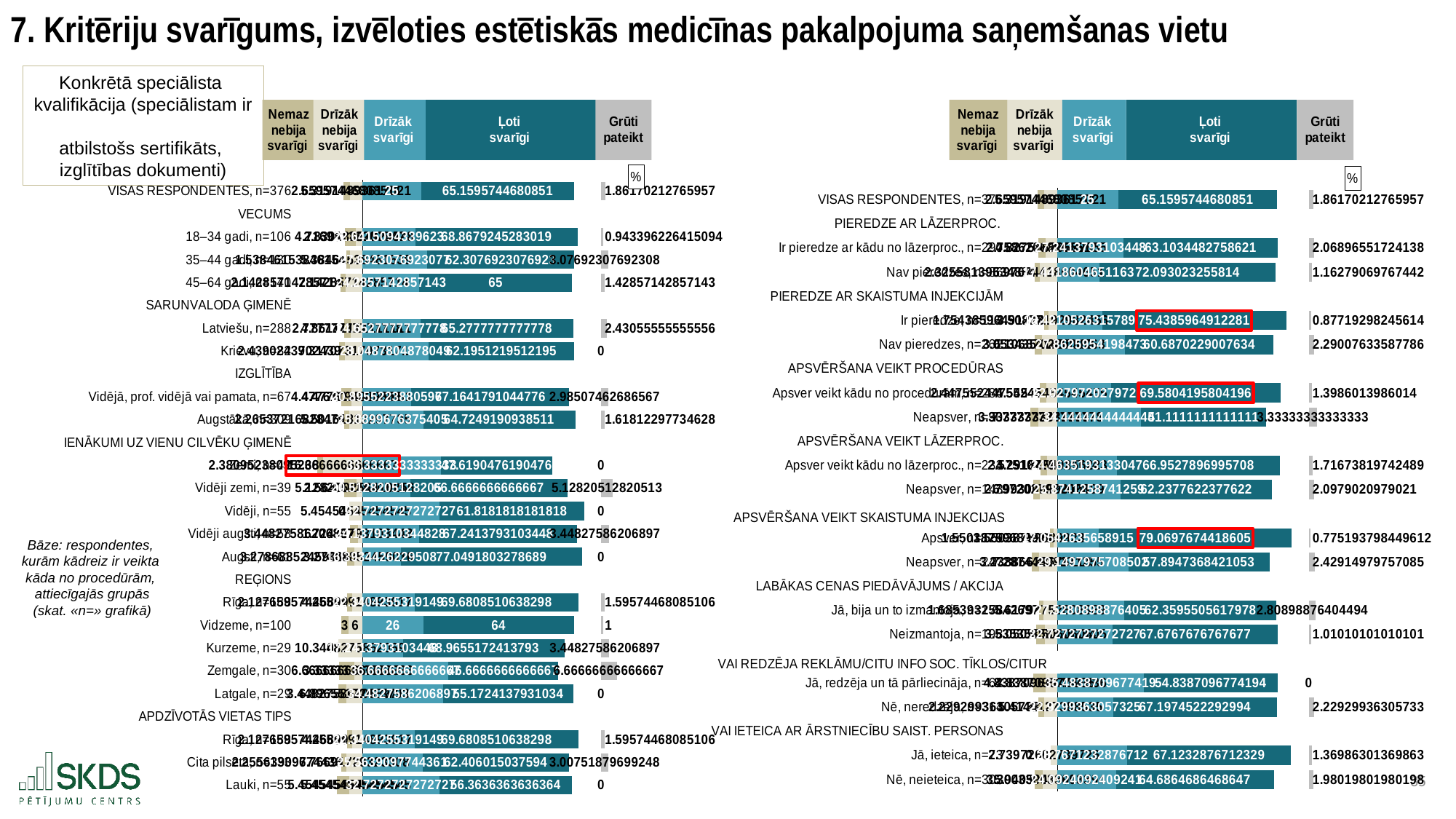
In the left chart, what is the difference in 'Ļoti svarīgi' between Vidzeme, n=100 and 45–64 gadi? 1 How many response categories does the legend list for each chart? 5 In the left chart, what is the 'Drīzāk svarīgi' value for Vidzeme, n=100? 26 In the right chart, what is the 'Ļoti svarīgi' value for the row 'Ir pieredze' under PIEREDZE AR SKAISTUMA INJEKCIJĀM? 75.4385964912281 In the right chart, what is the 'Grūti pateikt' value for 'Jā, redzēja un tā pārliecināja'? 0 In the right chart, which row has the highest 'Ļoti svarīgi' value? Apsver (APSVĒRŠANA VEIKT SKAISTUMA INJEKCIJAS), 79.0697674418605 In the left chart, what is the total of all segments for Vidzeme, n=100? 100 In the left chart, what is the 'Grūti pateikt' value for Zemgale, n=30? 6.66666666666667 In the left chart, what is the 'Ļoti svarīgi' value for VISAS RESPONDENTES, n=376? 65.1595744680851 In the left chart, what is the 'Ļoti svarīgi' value for Vidzeme, n=100? 64 In the right chart, which is larger for 'Ļoti svarīgi': 'Jā, ieteica' or 'Nē, neieteica'? Jā, ieteica What type of chart is used on this slide? stacked bar chart